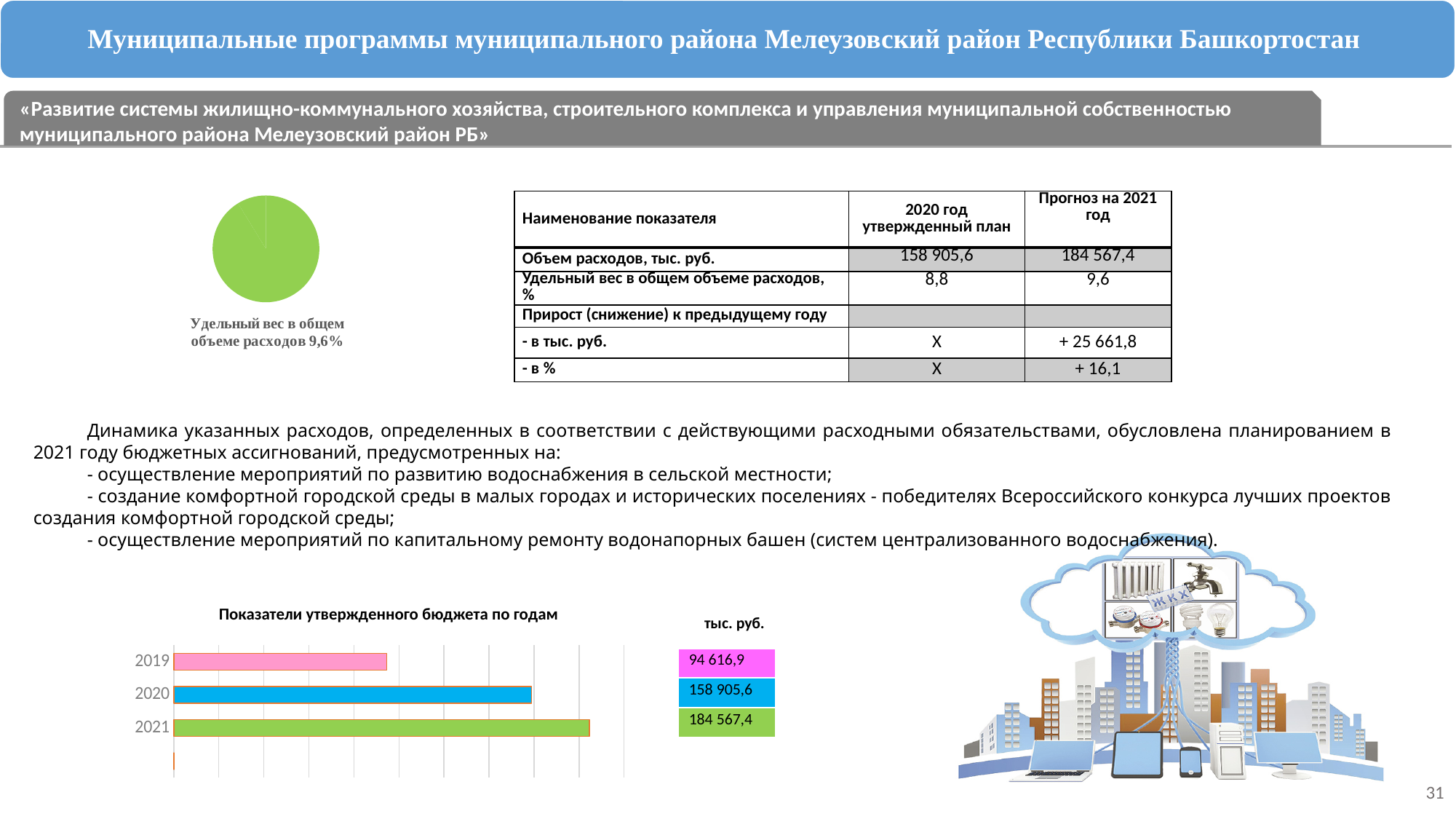
What unit is indicated next to the chart "Показатели утвержденного бюджета по годам"? тыс. руб. What kind of chart is the chart titled "Показатели утвержденного бюджета по годам"? bar chart In the chart "Показатели утвержденного бюджета по годам", which year has the highest value? 2021 In the chart "Показатели утвержденного бюджета по годам", what is the difference between the values for 2021 and 2020? 25 661,8 In the chart "Показатели утвержденного бюджета по годам", which is larger, the value for 2019 or the value for 2020? 2020 In the chart "Показатели утвержденного бюджета по годам", what is the value for 2020? 158 905,6 What kind of chart is the chart at the top left of the slide, captioned "Удельный вес в общем объеме расходов 9,6%"? pie chart In the chart "Показатели утвержденного бюджета по годам", what is the value for 2019? 94 616,9 In the chart "Показатели утвержденного бюджета по годам", do the values rise or fall from 2019 to 2021? rise How many years are shown in the chart "Показатели утвержденного бюджета по годам"? 3 In the chart "Показатели утвержденного бюджета по годам", which year has the lowest value? 2019 In the chart "Показатели утвержденного бюджета по годам", what is the value for 2021? 184 567,4